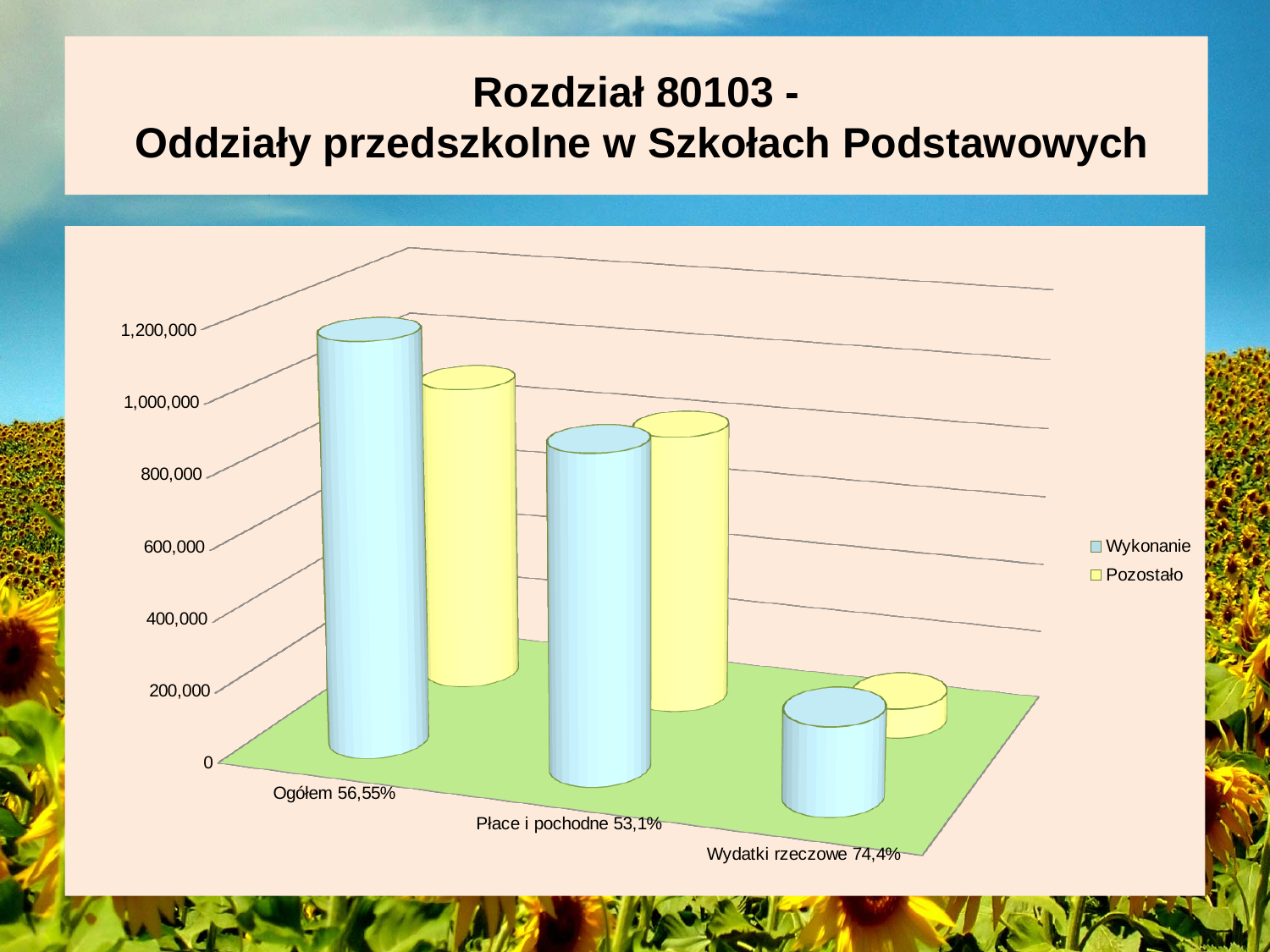
Which series does the legend list first? Wykonanie How many categories are shown on the x axis of the chart? 3 How many series does the chart legend list? 2 For Ogółem 56,55%, which is larger: Wykonanie or Pozostało? Wykonanie What is the title of the slide containing the chart? Rozdział 80103 - Oddziały przedszkolne w Szkołach Podstawowych Which category has the shortest Pozostało bar? Wydatki rzeczowe 74,4% Is the Wykonanie value for Ogółem 56,55% greater or less than 1,000,000? greater Which category has the tallest Wykonanie bar? Ogółem 56,55% Is the Wykonanie value for Płace i pochodne 53,1% greater or less than 600,000? greater Is the Wykonanie value for Wydatki rzeczowe 74,4% greater or less than 400,000? less For Wydatki rzeczowe 74,4%, which is larger: Wykonanie or Pozostało? Wykonanie What kind of chart is shown on the slide? bar chart